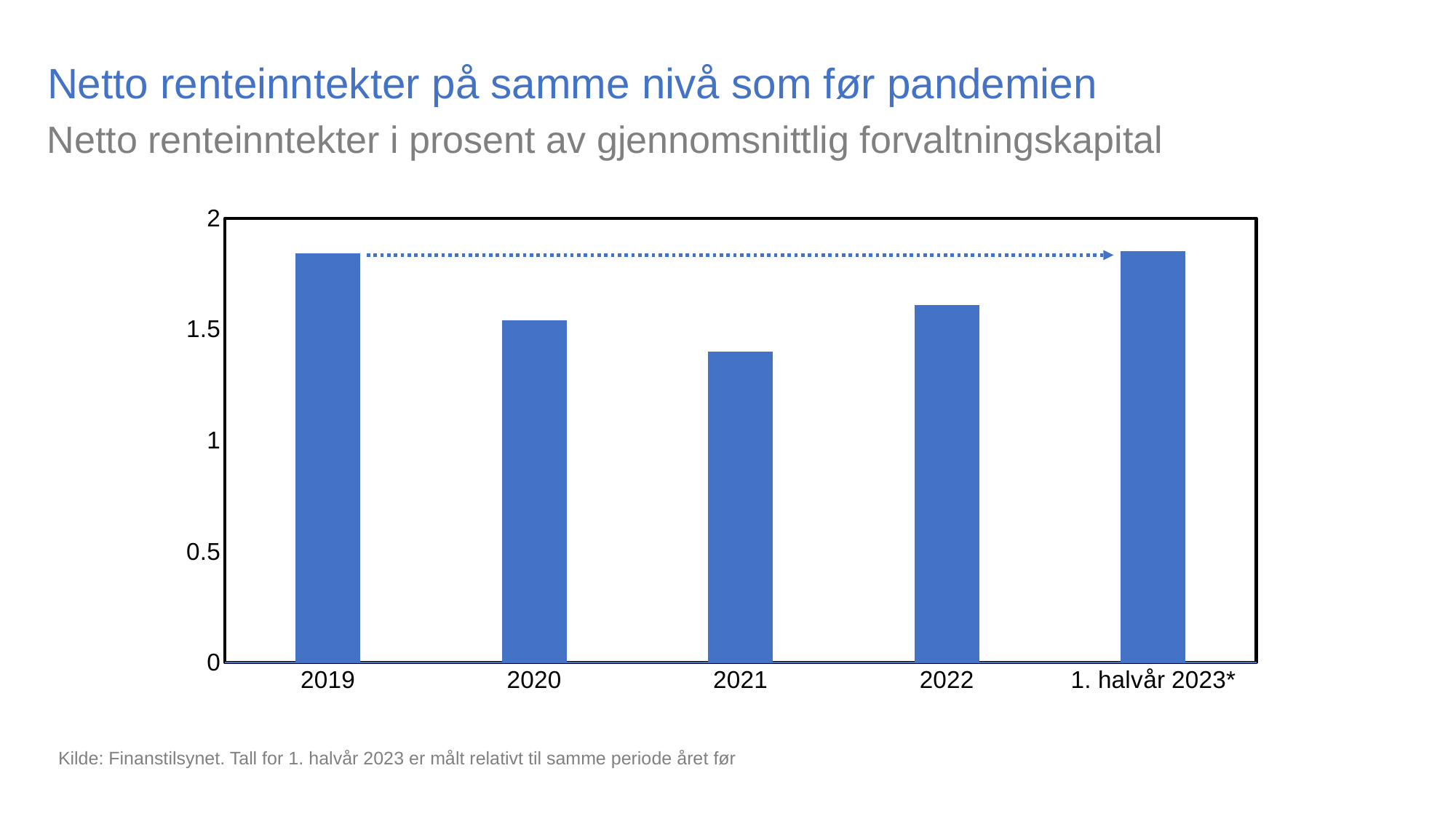
Is the value for 2021 greater or less than 1.5? less Which category has the lowest value in the chart? 2021 How many categories are shown on the x axis of the chart? 5 Do the values rise or fall from 2019 to 2021? fall What kind of chart is shown on the slide? bar chart Which is larger, the value for 2022 or the value for 2021? 2022 Is the value for 1. halvår 2023* greater or less than 2? less Is the value for 2020 greater or less than 1? greater Which is larger, the value for 2019 or the value for 2021? 2019 What is the subtitle describing what the chart shows? Netto renteinntekter i prosent av gjennomsnittlig forvaltningskapital